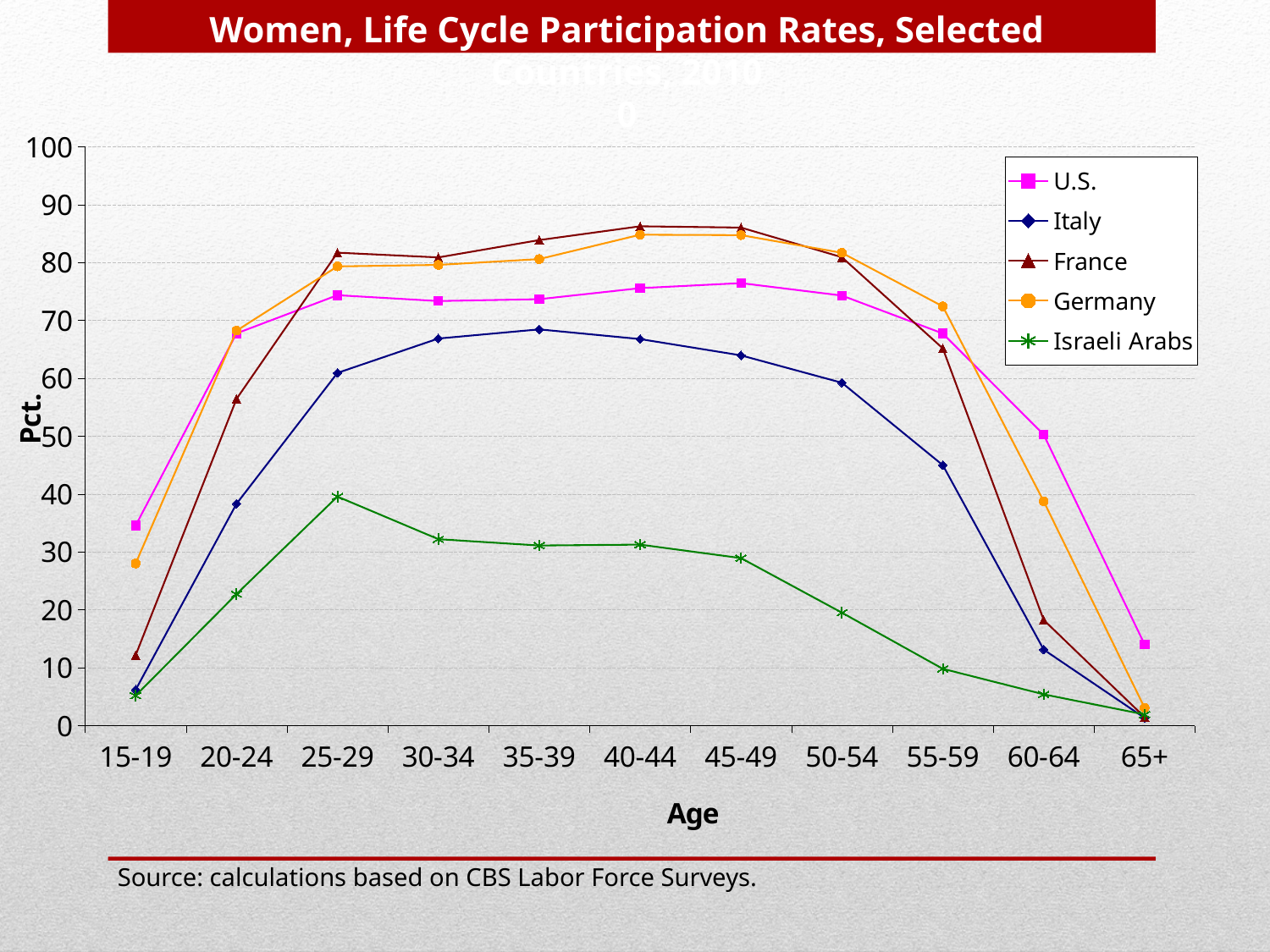
Is the value for U.S. at 60-64 greater or less than 40? greater Which series has the highest value for the 15-19 age group? U.S. For which age group does the Israeli Arabs series reach its highest value? 25-29 What is the label on the x axis? Age What kind of chart is shown on the slide? Line chart Does the Israeli Arabs series rise or fall from 25-29 to 65+? Fall Is the value for France at 15-19 greater or less than 20? less How many age groups are plotted along the x axis? 11 Which is larger at 60-64, the value for Germany or the value for France? Germany Which series has the lowest value for the 45-49 age group? Israeli Arabs How many series does the legend list? 5 Is the value for Italy at 55-59 greater or less than 50? less